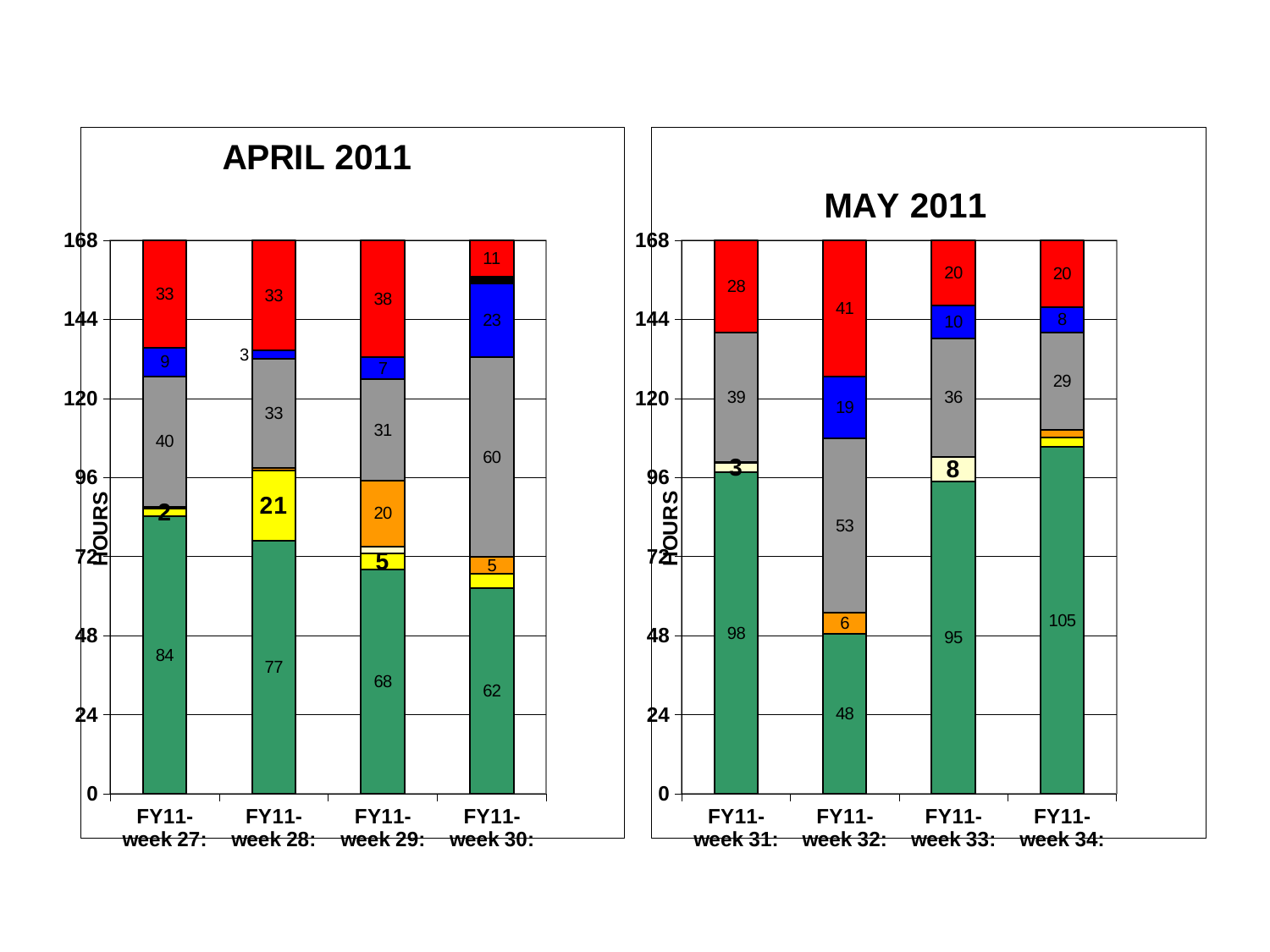
In the MAY 2011 chart, what is the value of the green segment for FY11-week 34? 105 In the APRIL 2011 chart, what is the difference between the green segments of FY11-week 27 and FY11-week 30? 22 In the MAY 2011 chart, what is the value of the grey segment for FY11-week 32? 53 In the APRIL 2011 chart, what is the value of the green segment for FY11-week 27? 84 In the MAY 2011 chart, which week has the smallest green segment? FY11-week 32 How many weeks are shown on the x axis of the APRIL 2011 chart? 4 In the APRIL 2011 chart, which week has the largest green segment? FY11-week 27 What kind of chart is the APRIL 2011 chart? Stacked bar chart In the MAY 2011 chart, is the red segment larger for FY11-week 31 or FY11-week 32? FY11-week 32 In the MAY 2011 chart, what total value does each stacked bar reach on the HOURS axis? 168 In the APRIL 2011 chart, what is the value of the red segment for FY11-week 29? 38 In the MAY 2011 chart, what is the difference between the green segments of FY11-week 34 and FY11-week 32? 57